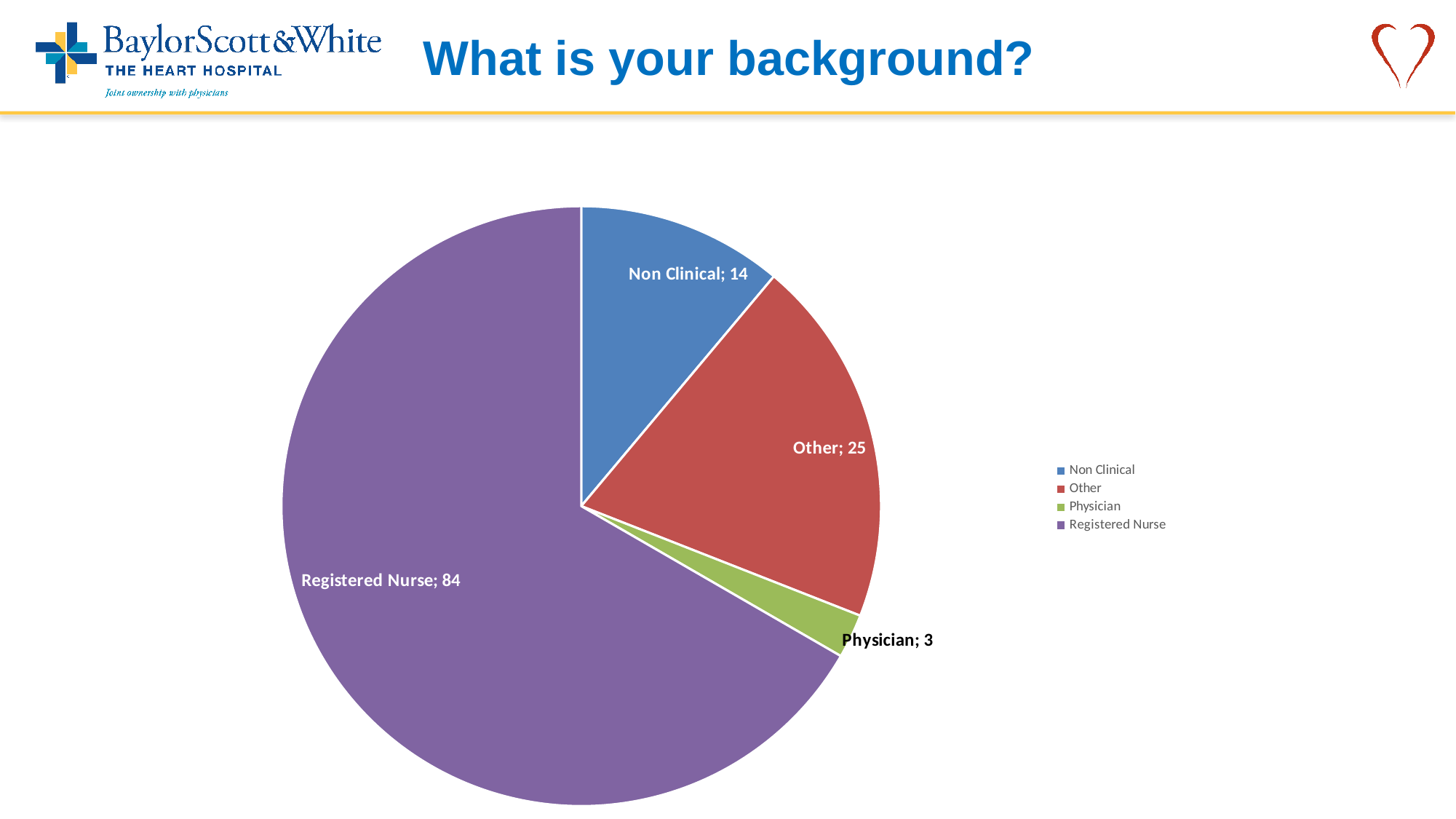
What is the value for Physician? 3 Which category has the smallest slice? Physician What is the value for Non Clinical? 14 Which is larger, Other or Non Clinical? Other Which category has the largest slice? Registered Nurse What is the difference between the Registered Nurse value and the Other value? 59 What is the value for Registered Nurse? 84 How many categories does the pie chart have? 4 What kind of chart is shown on the slide? pie chart What is the title of the slide containing the chart? What is your background? What is the value for Other? 25 What is the total of all slices in the pie chart? 126